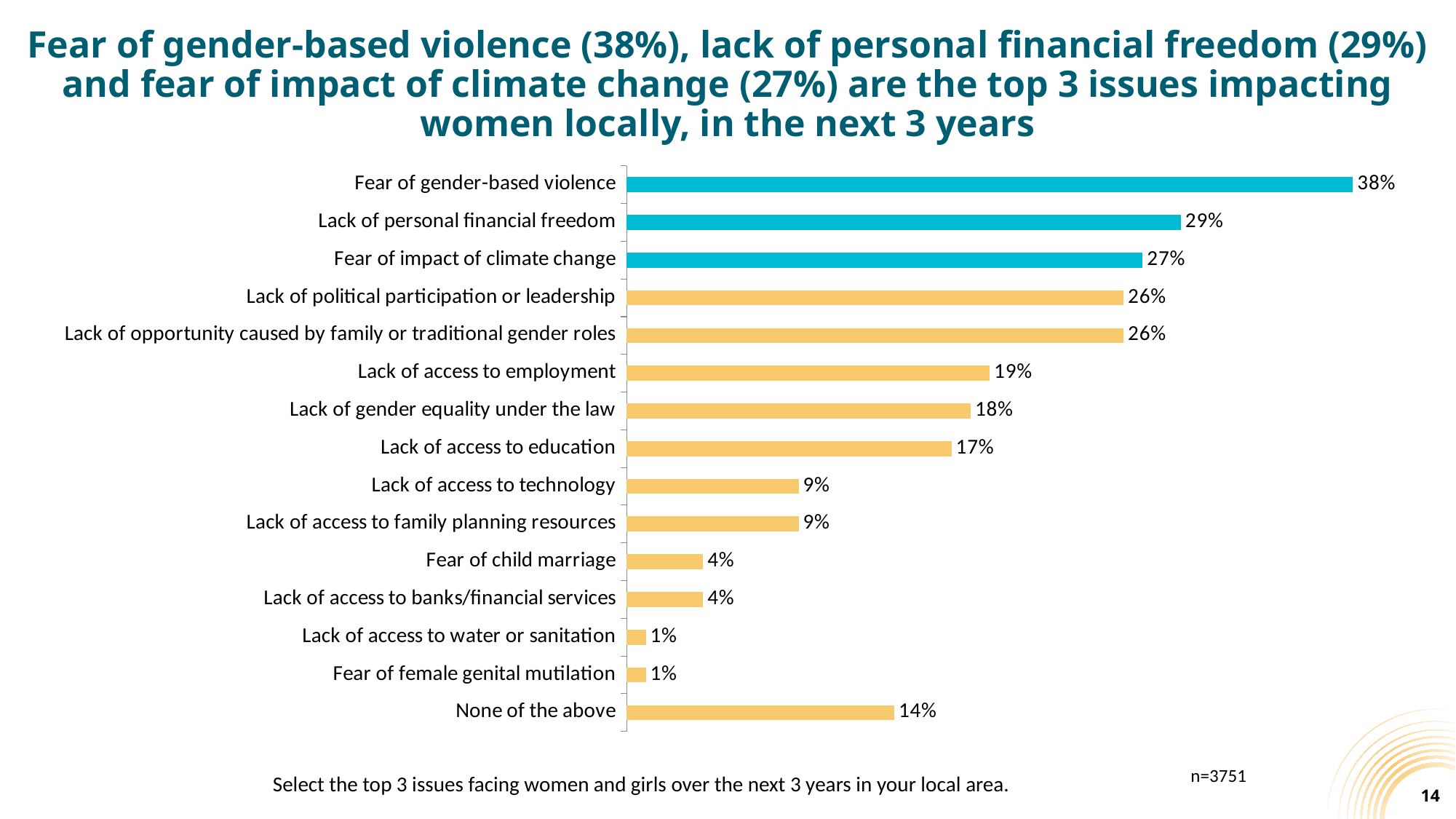
Which category has the highest value? Fear of gender-based violence What percentage is shown for None of the above? 14% What sample size (n) is shown on the slide? n=3751 Which is larger, Lack of access to technology or Lack of access to education? Lack of access to education What percentage is shown for Fear of gender-based violence? 38% Which is larger, Lack of gender equality under the law or None of the above? Lack of gender equality under the law What is the difference between Fear of gender-based violence and Lack of access to education? 21% What kind of chart is shown on the slide? Bar chart How many bars are coloured blue rather than yellow? 3 How many categories are shown in the chart? 15 What is the value for Lack of access to employment? 19% What is the difference between Lack of personal financial freedom and Fear of impact of climate change? 2%